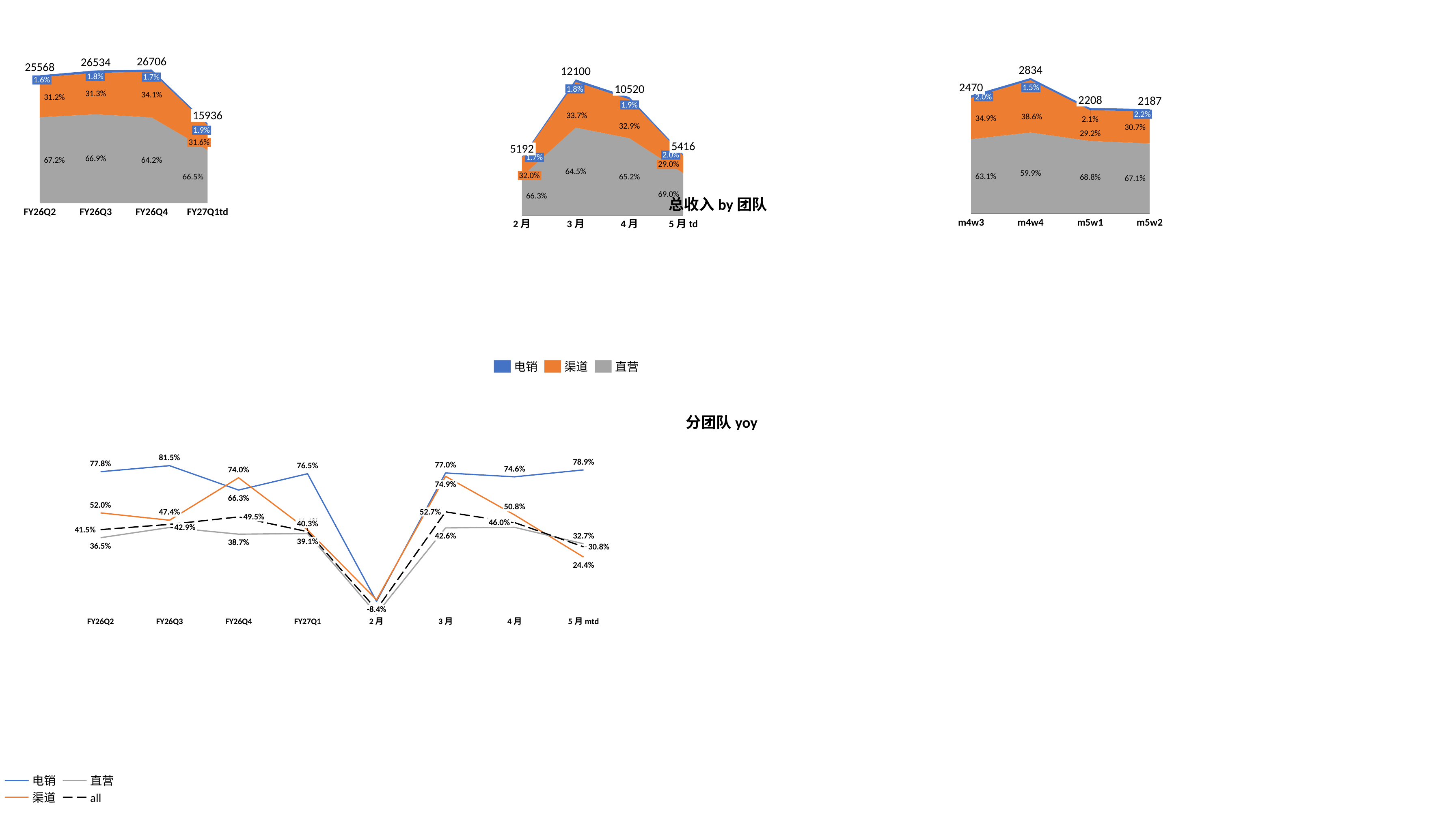
In the top-middle monthly chart, what is the difference between the totals for 3月 and 4月? 1580 In the top-right weekly chart, what is the 直营 share for m5w1? 68.8% In the top-left quarterly chart, what is the 直营 share for FY26Q2? 67.2% In the bottom 分团队 yoy chart, what is the 渠道 value for 5月 mtd? 24.4% In the bottom 分团队 yoy chart, what is the 电销 value for FY26Q3? 81.5% In the top-right weekly chart, how many weeks are shown on the x axis? 4 In the bottom 分团队 yoy chart, how many series does the legend list? 4 In the top-left quarterly chart, which quarter has the lowest total? FY27Q1td In the top-middle monthly chart, what is the 渠道 share for 5月td? 29.0% In the top-left quarterly chart, what is the total value labelled for FY26Q4? 26706 In the top-right weekly chart, which week has the highest total? m4w4 In the top-middle monthly chart, what is the total value labelled for 3月? 12100